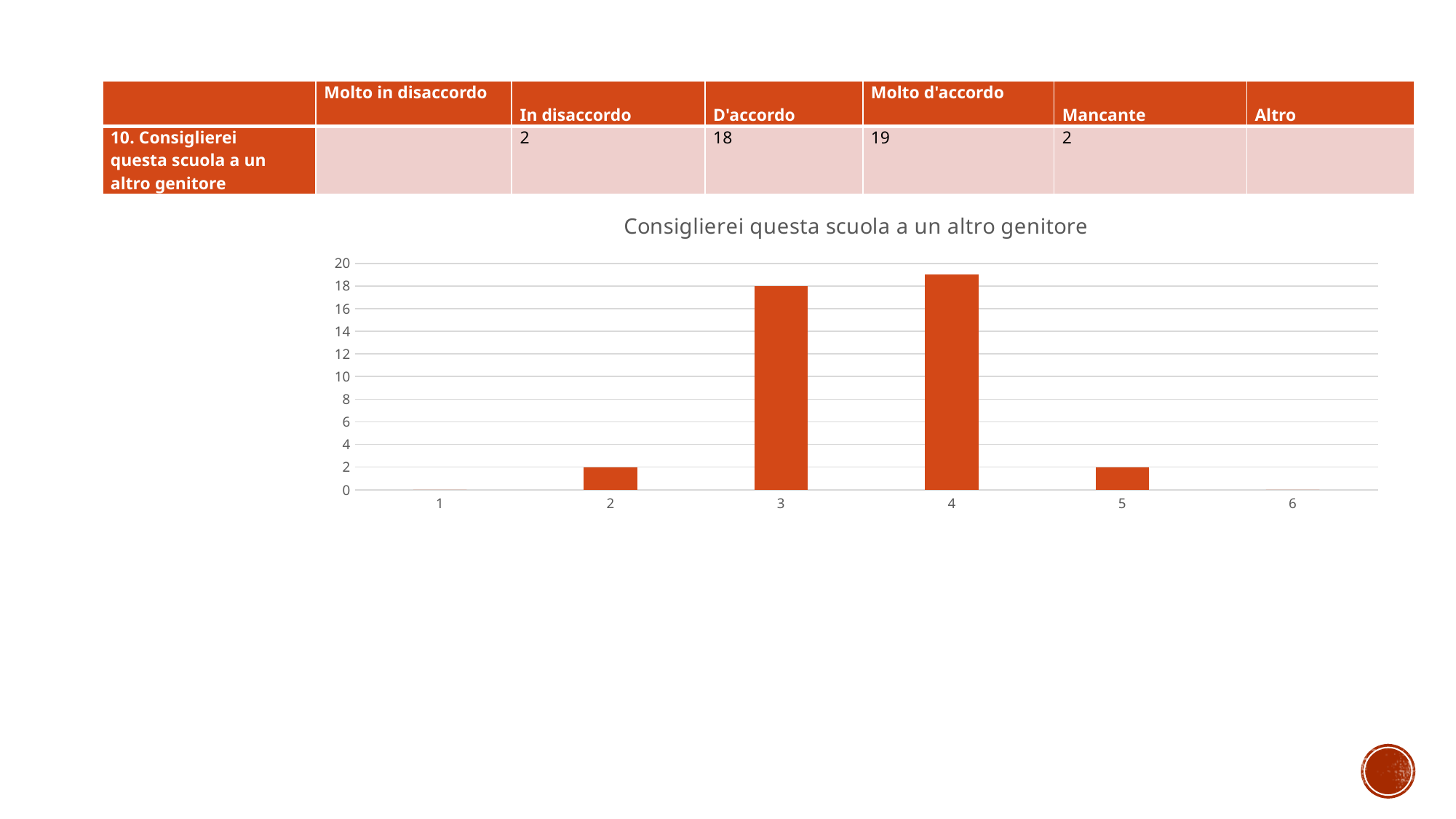
How many categories are labelled on the x axis? 6 What is the value of the bar for category 4? 19 What is the difference between the values for category 3 and category 2? 16 What is the value of the bar for category 3? 18 What is the title of the chart? Consiglierei questa scuola a un altro genitore Is the value for category 4 greater or less than 10? greater What kind of chart is shown on the slide? bar chart What is the difference between the values for category 4 and category 3? 1 Which is larger, the bar for category 3 or the bar for category 5? category 3 What is the value of the bar for category 5? 2 Which category has the highest bar? 4 What is the value of the bar for category 2? 2